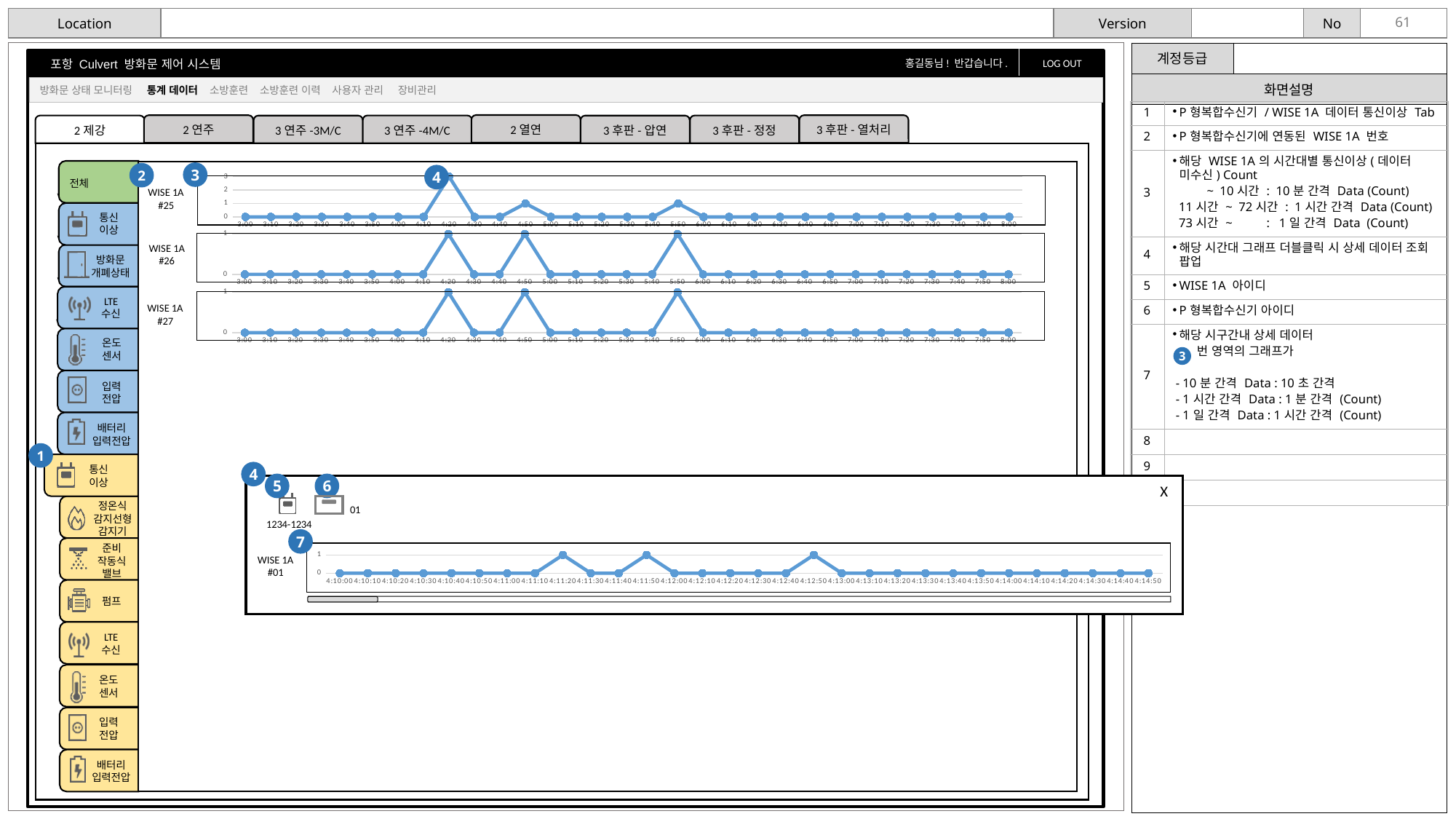
On the WISE 1A #25 chart, what is the value at 4:20? 3 What kind of chart is the WISE 1A #25 chart? line chart On the WISE 1A #26 chart, what is the value at 3:00? 0 How many line charts are shown on the slide in total? 4 On the WISE 1A #01 chart in the popup, what is the value at 4:11:20? 1 On the WISE 1A #25 chart, what is the difference between the value at 4:20 and the value at 4:50? 2 On the WISE 1A #26 chart, what is the value at 4:20? 1 On the WISE 1A #25 chart, at which time is the value highest? 4:20 On the WISE 1A #27 chart, what is the value at 5:50? 1 On the WISE 1A #26 chart, at how many time points does the value reach 1? 3 On the WISE 1A #25 chart, which is larger, the value at 4:20 or the value at 4:50? 4:20 What is the highest tick on the y axis of the WISE 1A #25 chart? 3